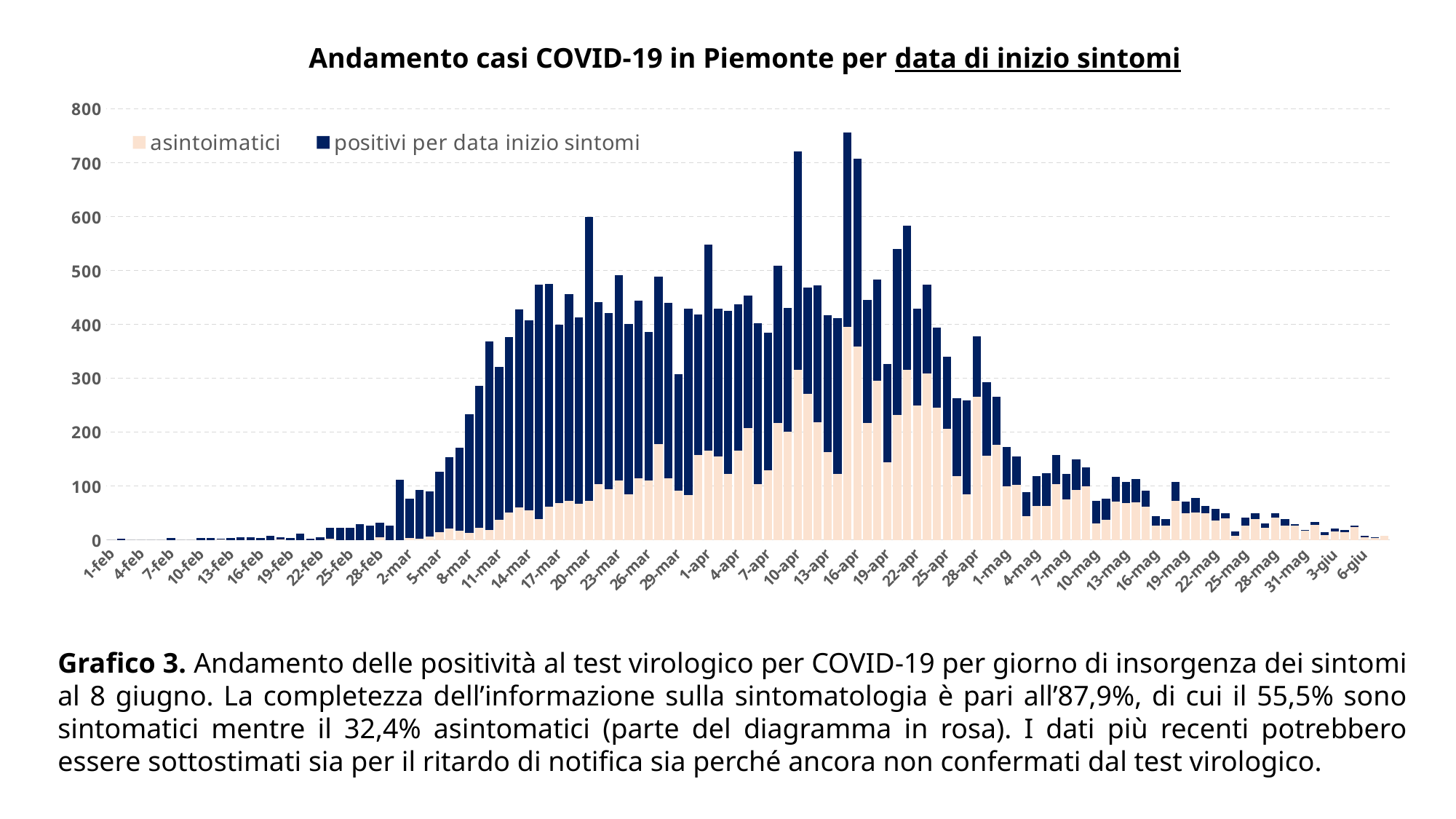
What is the title of the chart? Andamento casi COVID-19 in Piemonte per data di inizio sintomi How many series does the legend list? 2 Which bar is taller, the one at 20-mar or the one at 1-mag? 20-mar Do the bar heights generally rise or fall from 16-apr to 6-giu? fall Which date has the tallest bar in the chart? 15-apr What kind of chart is shown on the slide? bar chart Is the total value of the bar at 10-apr greater or less than 600? greater Is the total value of the bar at 1-feb greater or less than 100? less Is the total value of the bar at 6-giu greater or less than 100? less Which series is drawn in dark blue? positivi per data inizio sintomi